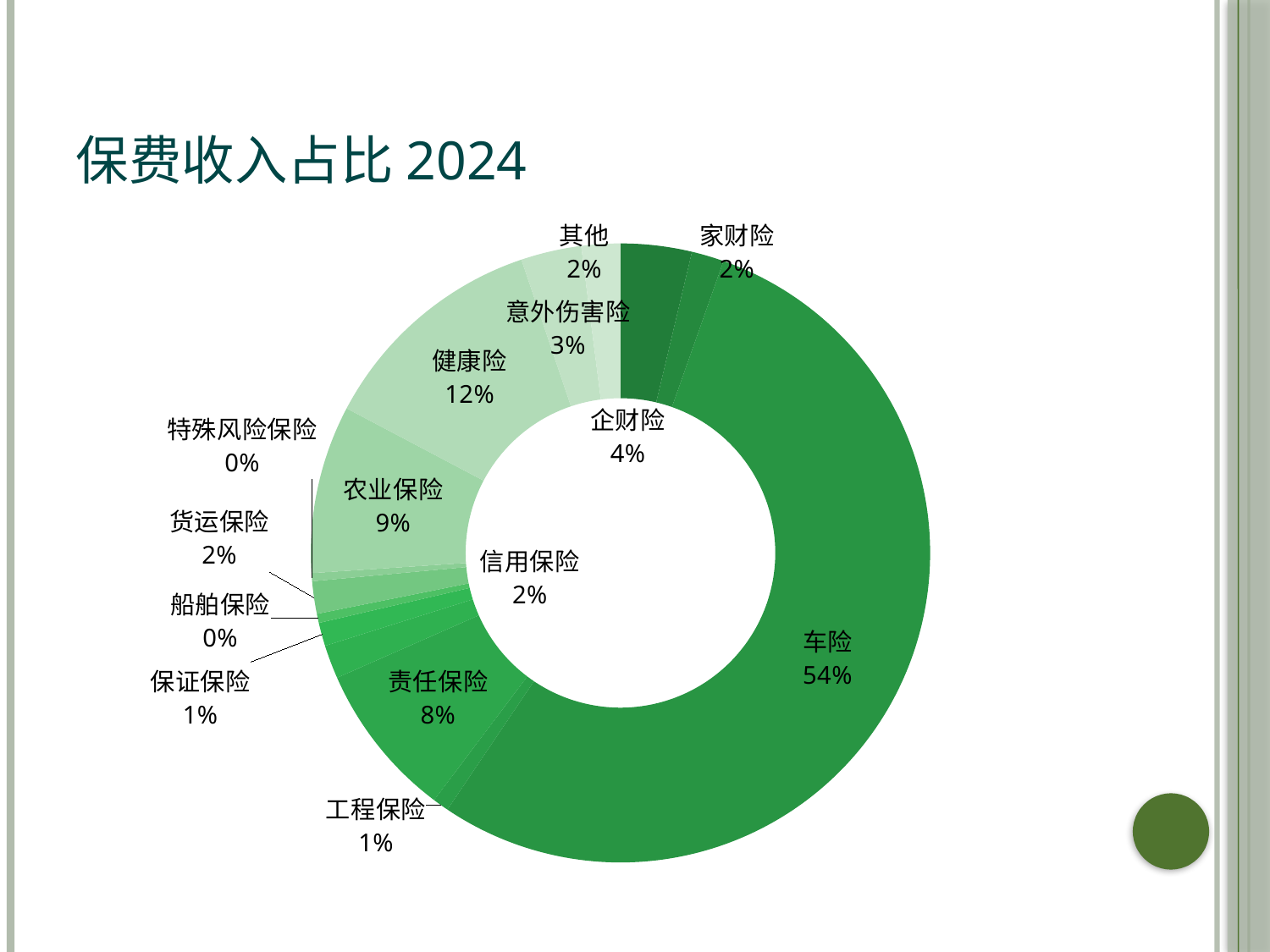
What is the difference in percentage points between 车险 and 健康险? 42 What is the value shown for 意外伤害险? 3% What is the value shown for 企财险? 4% What kind of chart is shown on the slide? doughnut chart What is the value shown for 农业保险? 9% Which is larger, the share for 健康险 or the share for 农业保险? 健康险 Which category has the largest share of premium income? 车险 What share of premium income does 车险 account for? 54% What is the value shown for 责任保险? 8% What is the value shown for 健康险? 12% How many categories are shown in the chart? 14 What is the title of the slide? 保费收入占比 2024